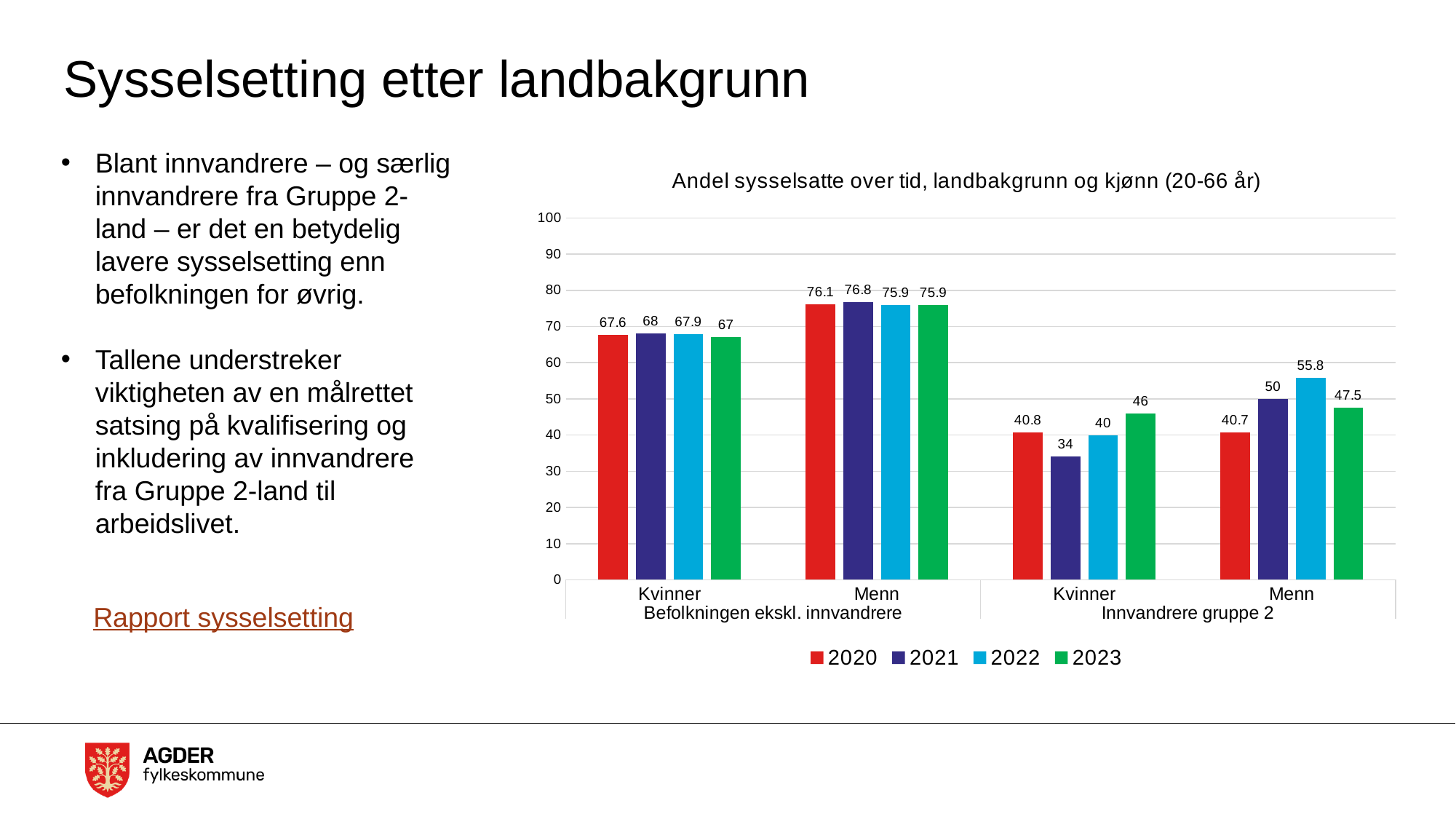
Which is larger: the 2023 value for Kvinner in Innvandrere gruppe 2 or the 2023 value for Menn in Innvandrere gruppe 2? Menn in Innvandrere gruppe 2 Is the 2020 value for Kvinner in the Innvandrere gruppe 2 group greater or less than 50? less What is the difference between the 2022 and 2020 values for Menn in the Innvandrere gruppe 2 group? 15.1 What kind of chart is shown on the slide? Bar chart What is the 2023 value for Kvinner in the Innvandrere gruppe 2 group? 46 What is the 2021 value for Kvinner in the Befolkningen ekskl. innvandrere group? 68 Which year has the highest value for Menn in the Befolkningen ekskl. innvandrere group? 2021 Which colour represents the 2023 series in the chart? Green What is the 2022 value for Menn in the Innvandrere gruppe 2 group? 55.8 How many series does the legend list? 4 What is the title of the chart? Andel sysselsatte over tid, landbakgrunn og kjønn (20-66 år) Which year has the lowest value for Kvinner in the Innvandrere gruppe 2 group? 2021